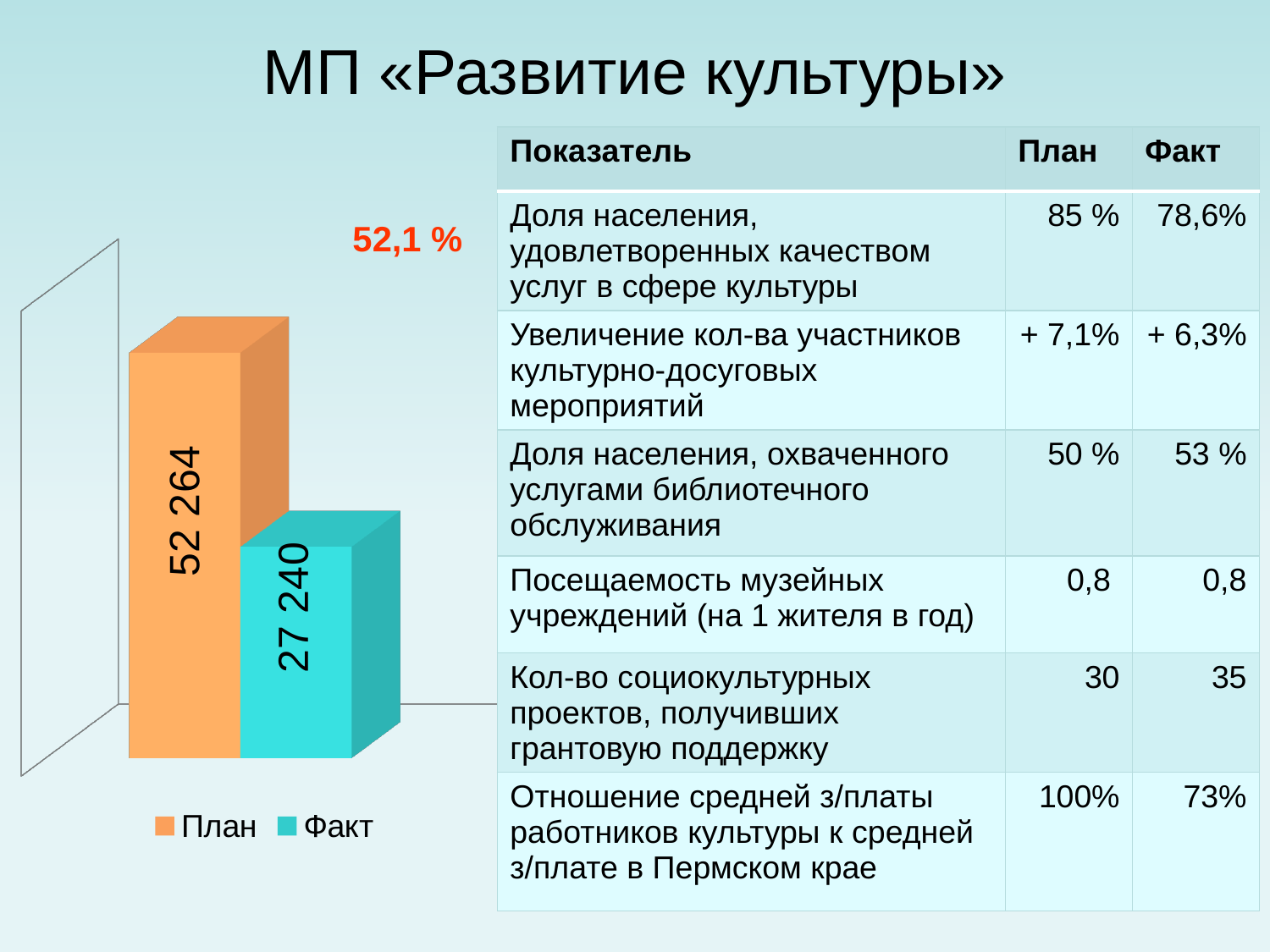
What is the value of the План bar in the chart? 52 264 What percentage is printed in red above the chart? 52,1 % How many series does the chart legend list? 2 Which bar in the chart is higher, План or Факт? План Which series has the lowest value in the chart? Факт What kind of chart is shown on the slide? Bar chart What is the value of the Факт bar in the chart? 27 240 Which colour represents the Факт series in the chart legend? Teal Which series has the highest value in the chart? План What is the difference between the План and Факт values in the chart? 25 024 How many bars are plotted in the chart? 2